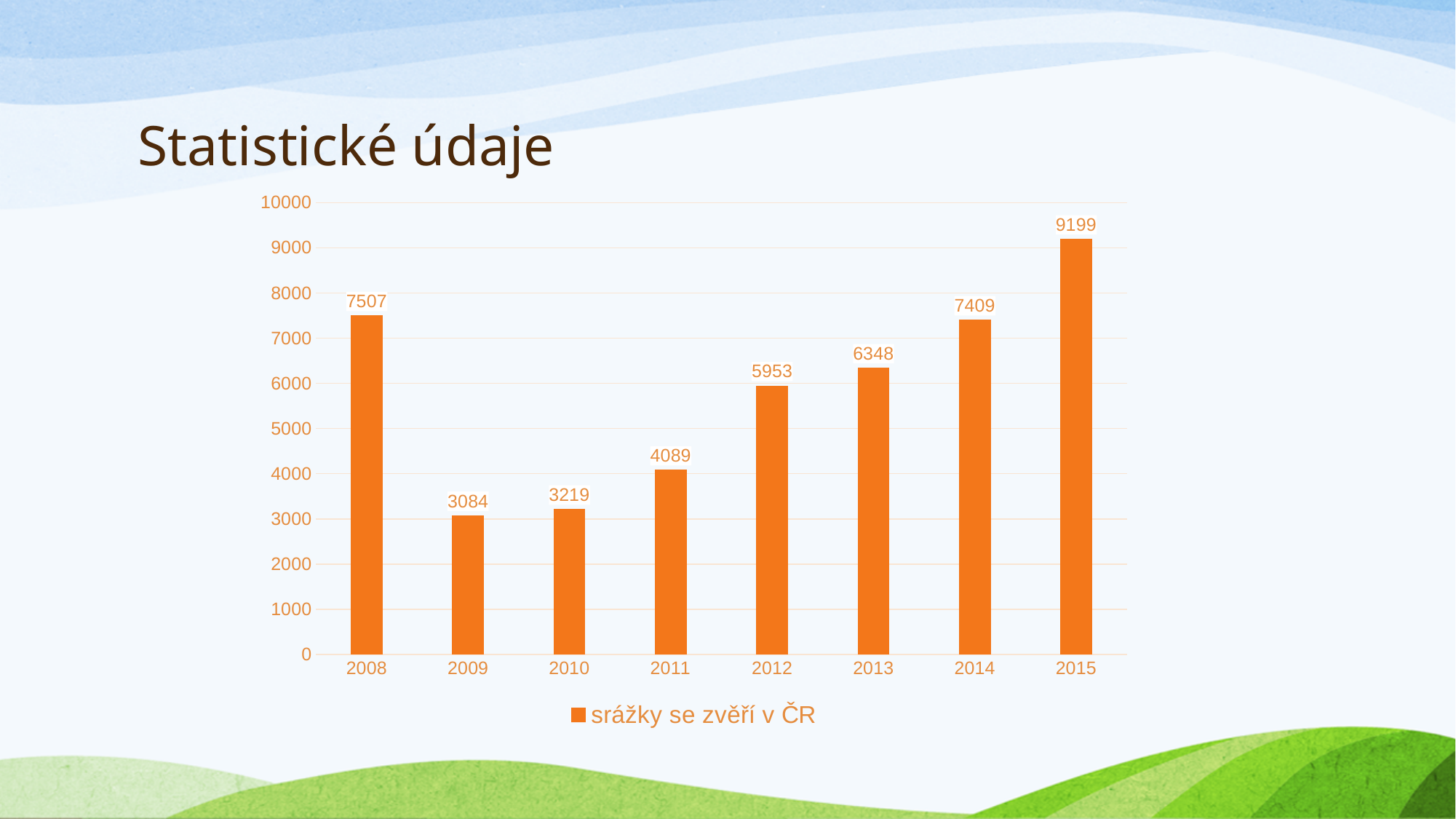
What is the value for 2012? 5953 Which year has the lowest value? 2009 What is the value for 2008? 7507 Which year has the highest value? 2015 What is the value for 2014? 7409 What is the difference between the values for 2010 and 2009? 135 Which is larger, the value for 2008 or the value for 2013? 2008 Is the value for 2011 greater or less than 5000? less What is the legend entry for the series? srážky se zvěří v ČR What kind of chart is shown on the slide? bar chart How many years are shown on the x axis? 8 What is the difference between the values for 2015 and 2014? 1790